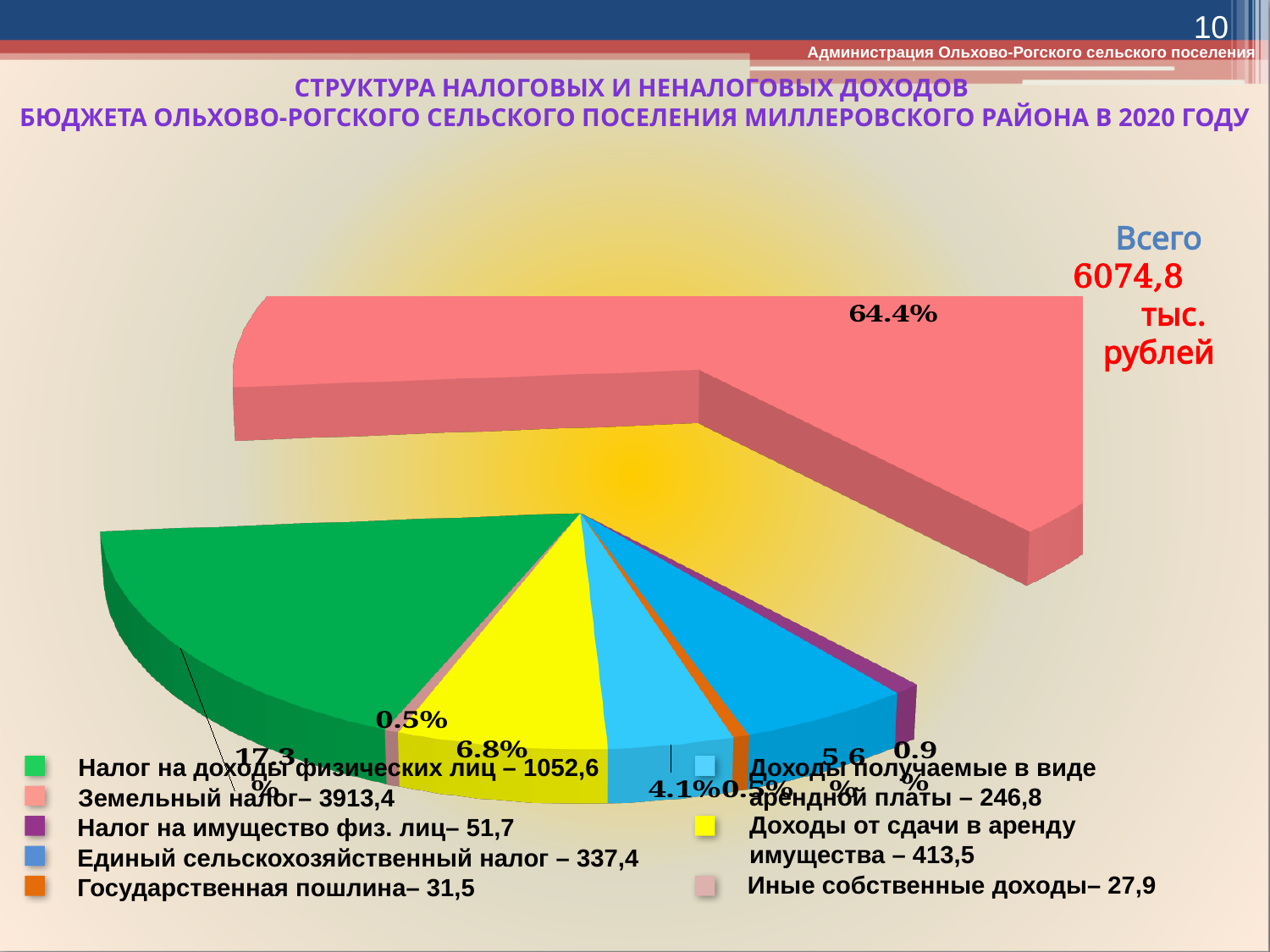
What kind of chart is shown on the slide? pie chart What percentage share does Земельный налог have in the pie chart? 64.4% What is the value for Государственная пошлина? 31,5 Which category has the smallest value in the legend? Иные собственные доходы How many categories does the legend list? 8 What is the value for Земельный налог in the legend? 3913,4 What percentage share does Налог на доходы физических лиц have? 17.3% Which category has the largest slice of the pie? Земельный налог What is the difference between the values for Земельный налог and Налог на доходы физических лиц? 2860,8 What is the value for Налог на доходы физических лиц? 1052,6 Which is larger: Единый сельскохозяйственный налог or Доходы от сдачи в аренду имущества? Доходы от сдачи в аренду имущества What total amount (Всего) is shown next to the chart? 6074,8 тыс. рублей